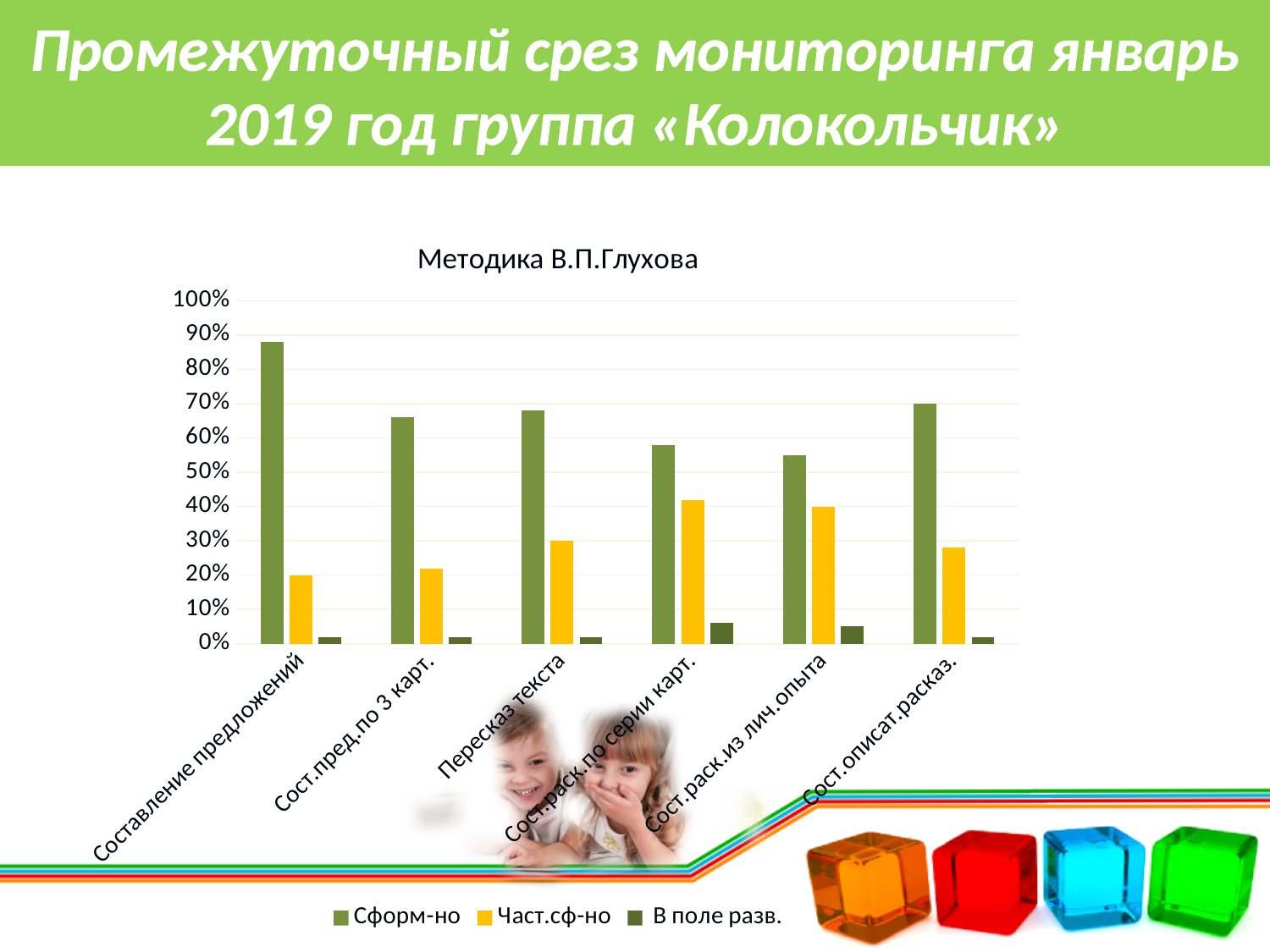
Is the Сформ-но value for Сост.пред.по 3 карт. greater or less than 60%? greater Which series is shown in yellow in the legend? Част.сф-но Which category has the highest value for the Сформ-но series? Составление предложений Which is larger: the Част.сф-но value for Сост.раск.по серии карт. or for Сост.пред.по 3 карт.? Сост.раск.по серии карт. How many series does the legend list? 3 What kind of chart is shown on the slide? bar chart Is the В поле разв. value for Сост.раск.из лич.опыта greater or less than 10%? less Which is larger: the Сформ-но value for Составление предложений or for Сост.описат.расказ.? Составление предложений Is the Сформ-но value for Составление предложений greater or less than 80%? greater What is the title of the chart? Методика В.П.Глухова How many categories are shown on the x axis? 6